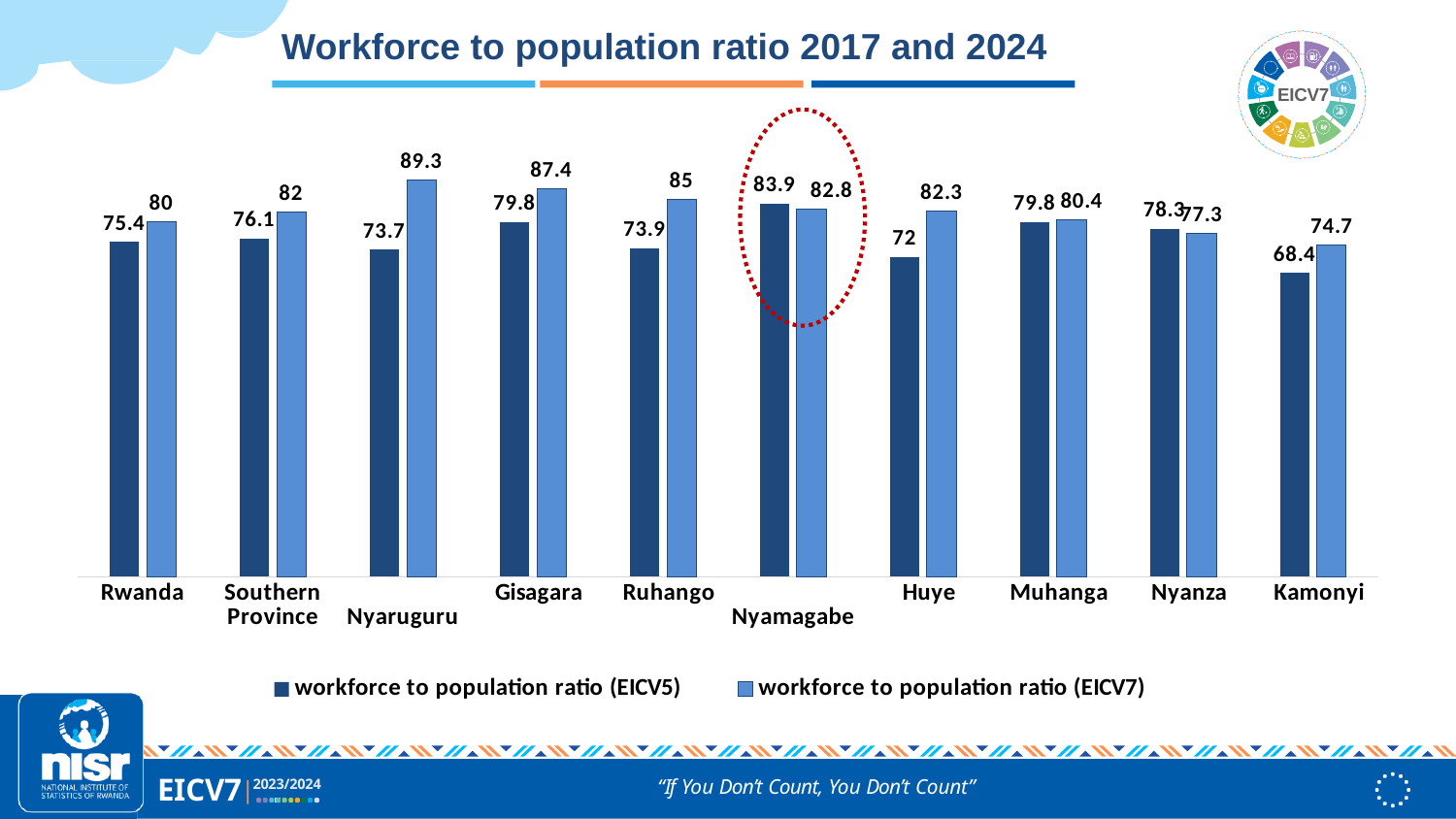
What is the difference between the EICV7 and EICV5 workforce to population ratios for Nyaruguru? 15.6 What is the workforce to population ratio (EICV7) for Nyaruguru? 89.3 Which category has the highest workforce to population ratio (EICV5)? Nyamagabe How many series does the legend list? 2 What is the workforce to population ratio (EICV7) for Southern Province? 82 What is the workforce to population ratio (EICV5) for Huye? 72 Which category has the lowest workforce to population ratio (EICV5)? Kamonyi For Nyamagabe, which is larger: the EICV5 or the EICV7 workforce to population ratio? EICV5 How many categories are shown on the x axis of the chart? 10 What is the difference between the EICV7 and EICV5 workforce to population ratios for Huye? 10.3 Which category has the highest workforce to population ratio (EICV7)? Nyaruguru What kind of chart is shown on the slide? Bar chart